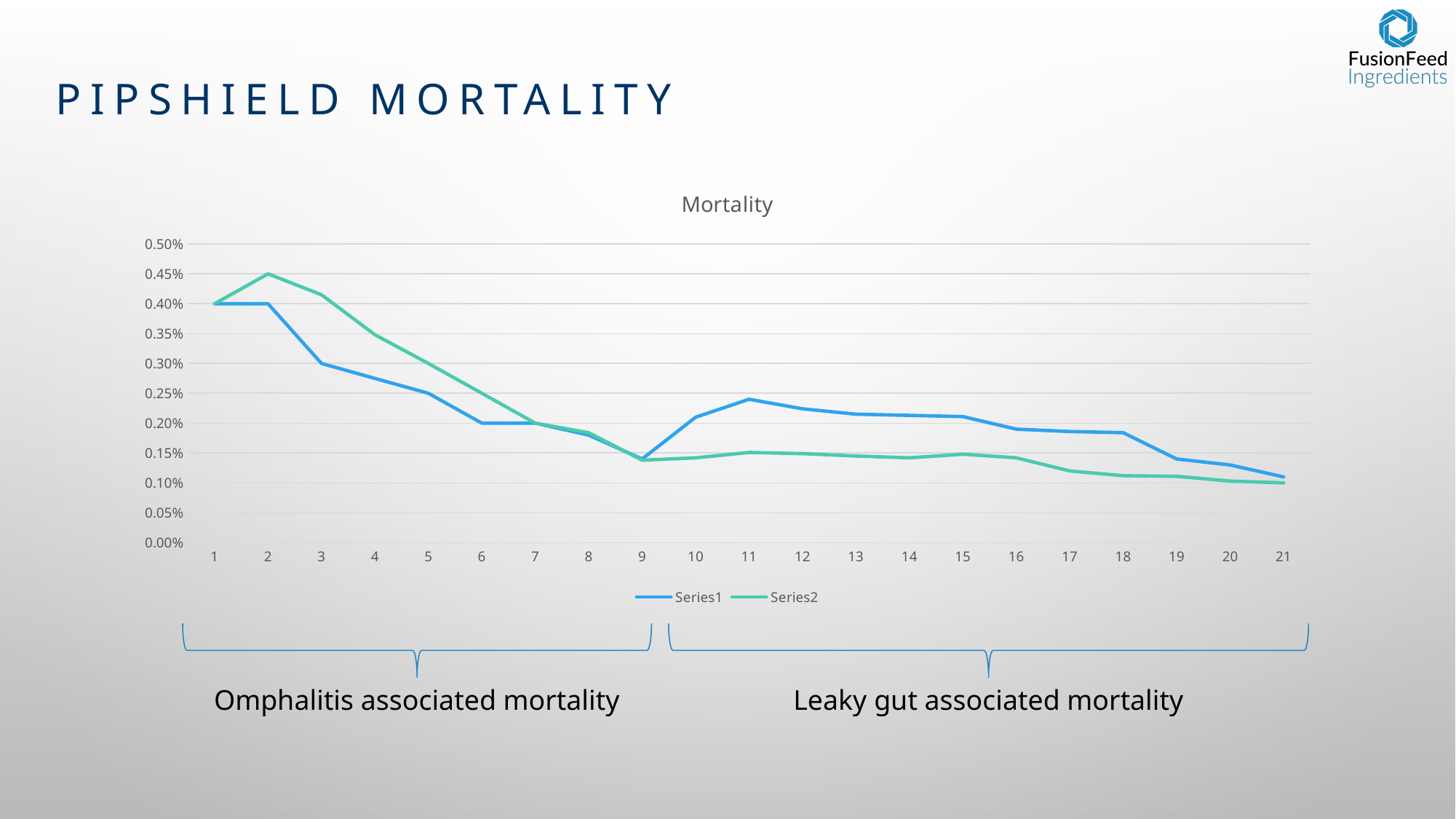
Overall, do the Series2 values rise or fall from point 2 to point 21? fall At which x-axis point does Series2 reach its highest value? 2 Is the value of Series2 at point 4 greater or less than 0.30%? greater What kind of chart is shown on the slide? line chart What is the value of Series2 at point 2? 0.45% Which series has the higher value at point 11? Series1 Is the value of Series1 at point 19 greater or less than 0.15%? less How many series does the legend list? 2 What is the value of Series1 at point 3? 0.30% What is the value of Series1 at point 1? 0.40% How many points are plotted along the x axis for each series? 21 What is the title of the chart? Mortality